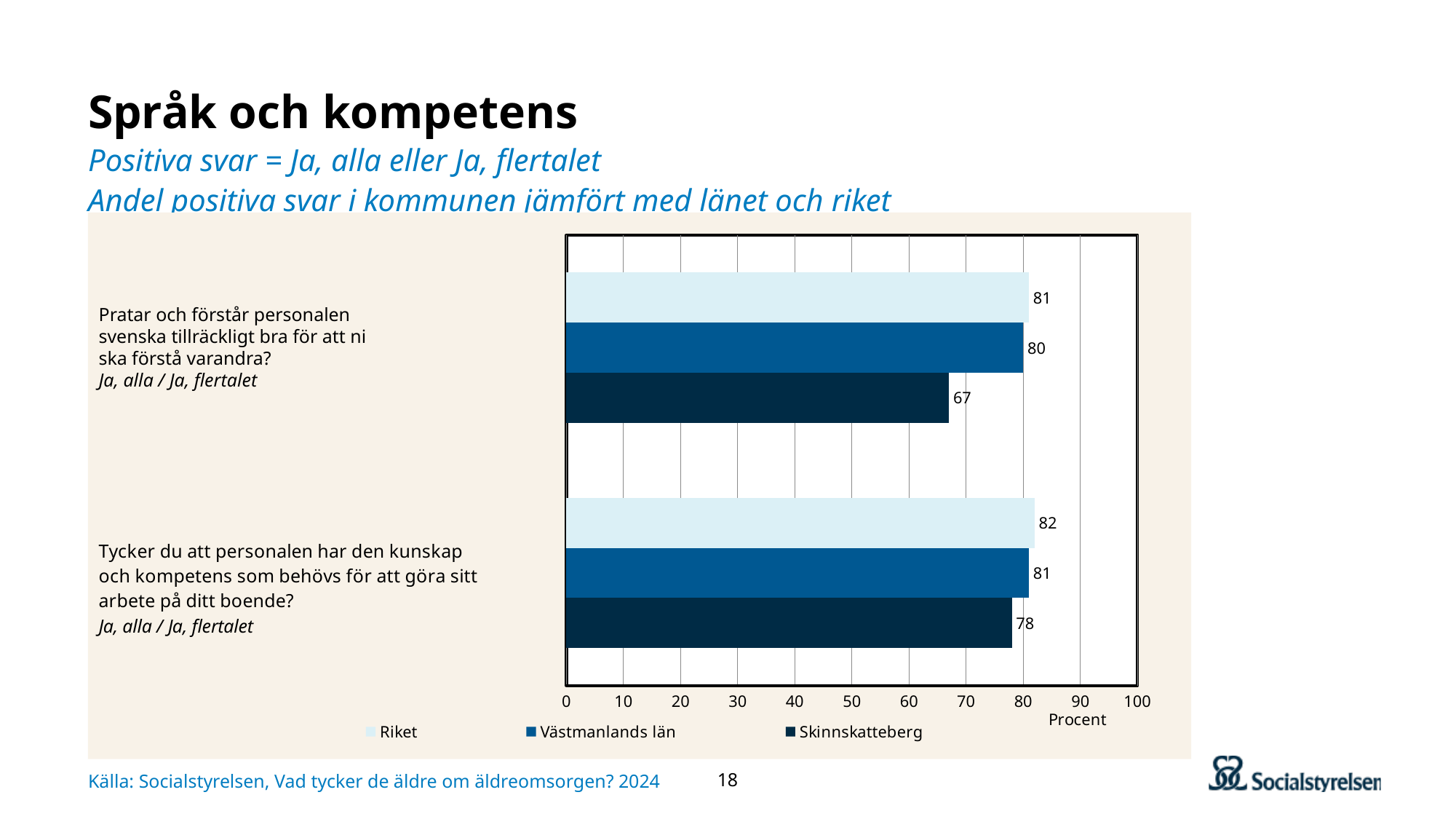
What unit is shown on the x axis of the chart? Procent What is the difference between Riket and Skinnskatteberg on the question about whether staff speak and understand Swedish well enough? 14 Which series has the highest value on the question about whether staff have the knowledge and competence needed? Riket What is the value for Skinnskatteberg on the question about whether staff have the knowledge and competence needed? 78 What is the value for Skinnskatteberg on the question about whether staff speak and understand Swedish well enough (Pratar och förstår personalen svenska tillräckligt bra)? 67 What is the difference between Västmanlands län and Skinnskatteberg on the question about whether staff have the knowledge and competence needed? 3 What is the value for Riket on the question about whether staff have the knowledge and competence needed (Tycker du att personalen har den kunskap och kompetens som behövs)? 82 What kind of chart is shown on the slide? Bar chart How many series does the legend list? 3 Which series has the lowest value on the question about whether staff speak and understand Swedish well enough? Skinnskatteberg What is the value for Västmanlands län on the question about whether staff speak and understand Swedish well enough? 80 Is the value for Skinnskatteberg higher on the question about Swedish language or on the question about knowledge and competence? Knowledge and competence (78)